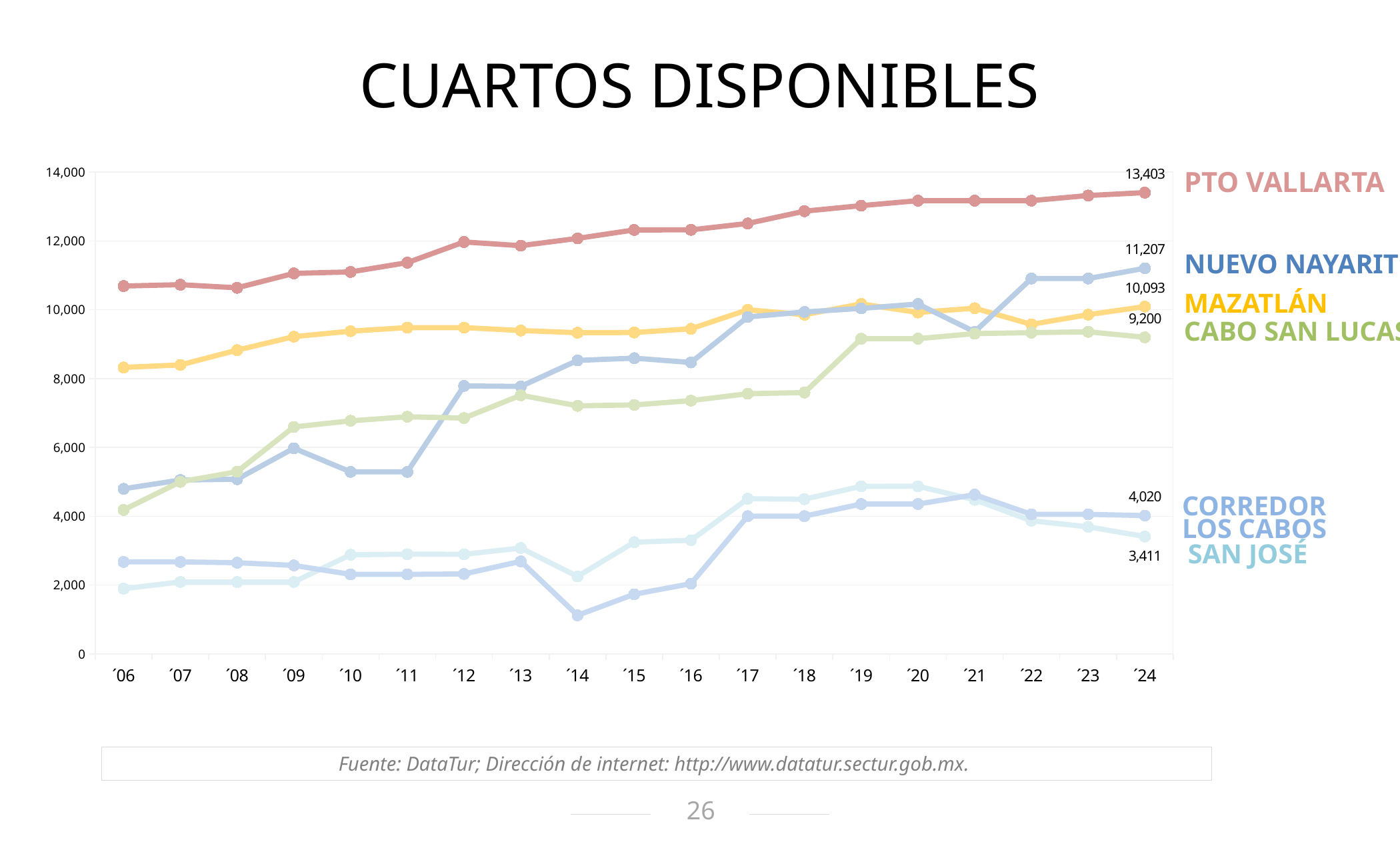
What is the value for NUEVO NAYARIT in ´24? 11,207 What is the value for PTO VALLARTA in ´24? 13,403 What kind of chart is shown on the slide? Line chart What is the difference between CORREDOR LOS CABOS and SAN JOSÉ in ´24? 609 How many years are shown on the x axis? 19 What is the difference between PTO VALLARTA and NUEVO NAYARIT in ´24? 2,196 What is the value for MAZATLÁN in ´24? 10,093 Is the value for PTO VALLARTA in ´06 greater or less than 10,000? greater Which series has the lowest value in ´24? SAN JOSÉ In ´24, which is larger: MAZATLÁN or CABO SAN LUCAS? MAZATLÁN Which series has the highest value in ´24? PTO VALLARTA What is the value for SAN JOSÉ in ´24? 3,411